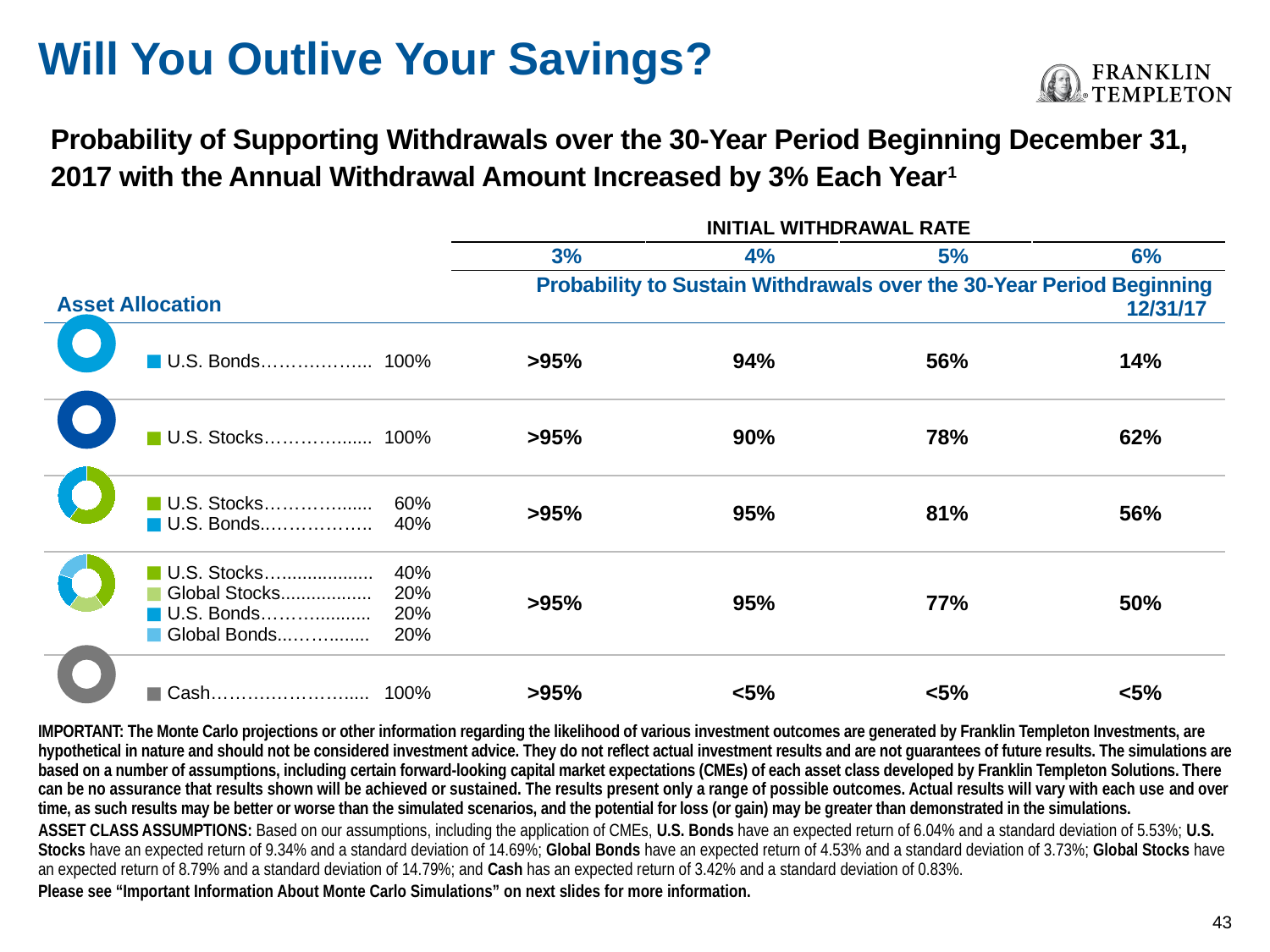
What kind of chart is used to show each asset allocation on the left of the slide? doughnut chart In the table, what is the probability to sustain withdrawals for the 100% U.S. Stocks allocation at a 5% initial withdrawal rate? 78% How many asset allocation pie charts are shown on the slide? 5 In the first pie chart from the top, what share is U.S. Bonds? 100% In the fourth pie chart from the top, which asset class has the largest slice? U.S. Stocks In the third pie chart from the top (U.S. Stocks / U.S. Bonds), what share is U.S. Stocks? 60% How many slices does the fourth pie chart from the top (U.S. Stocks, Global Stocks, U.S. Bonds, Global Bonds) have? 4 In the third pie chart from the top (U.S. Stocks / U.S. Bonds), what share is U.S. Bonds? 40% What colour is the Cash slice in the bottom pie chart? gray In the third pie chart from the top, which slice is larger, U.S. Stocks or U.S. Bonds? U.S. Stocks In the third pie chart from the top, what is the difference between the U.S. Stocks share and the U.S. Bonds share? 20%